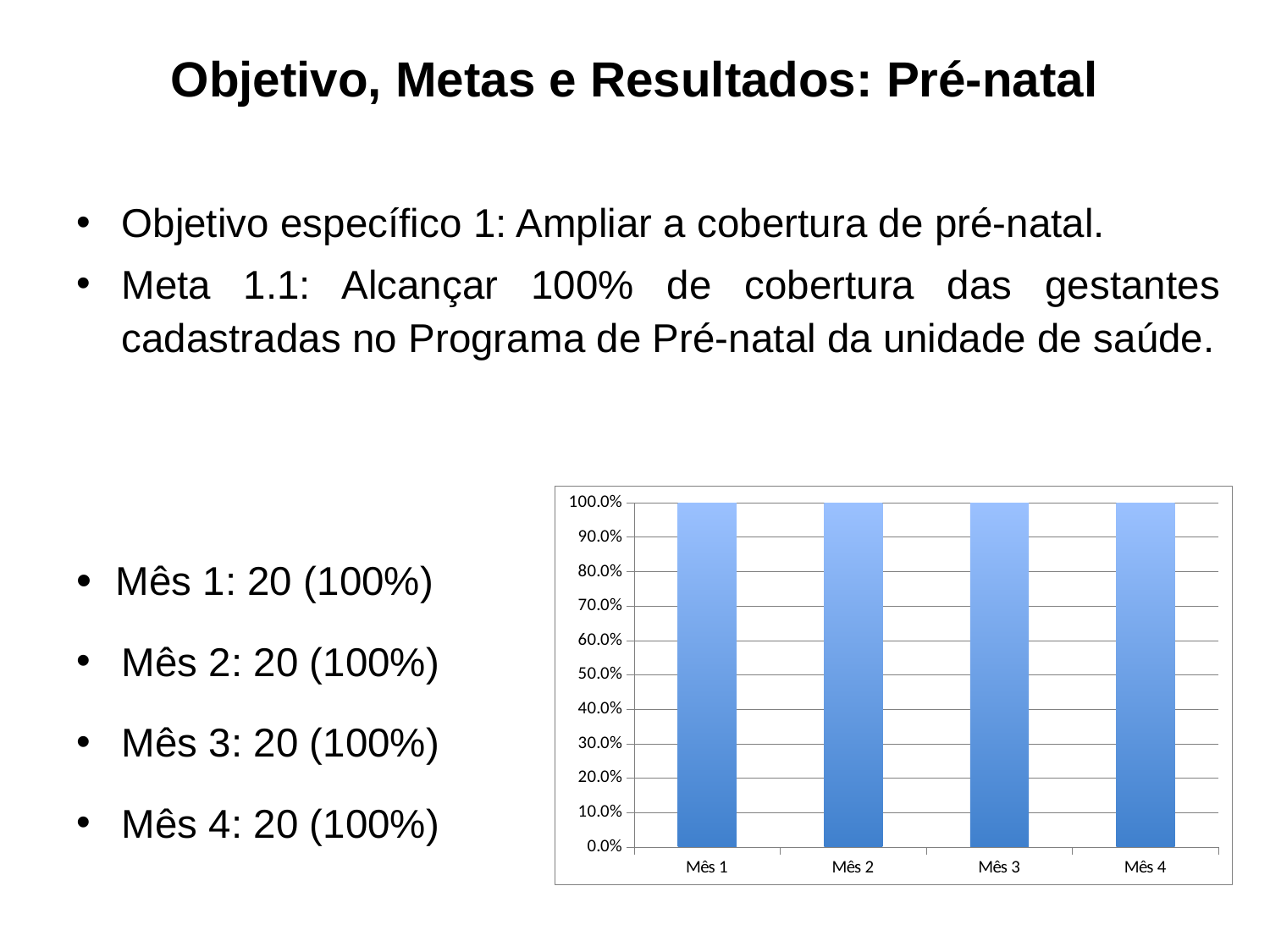
What value does the bar for Mês 3 reach on the chart? 100.0% What value does the bar for Mês 1 reach on the chart? 100.0% Do the values rise, fall, or stay flat from Mês 1 to Mês 4? stay flat What is the label of the first category on the x axis? Mês 1 What kind of chart is shown on the slide? bar chart How many categories are plotted on the x axis of the chart? 4 Is the value for Mês 4 greater or less than 50.0%? greater Is the value for Mês 2 greater or less than 90.0%? greater What is the difference between the values for Mês 1 and Mês 2? 0.0% What value does the bar for Mês 4 reach on the chart? 100.0% What is the highest tick value shown on the y axis of the chart? 100.0%